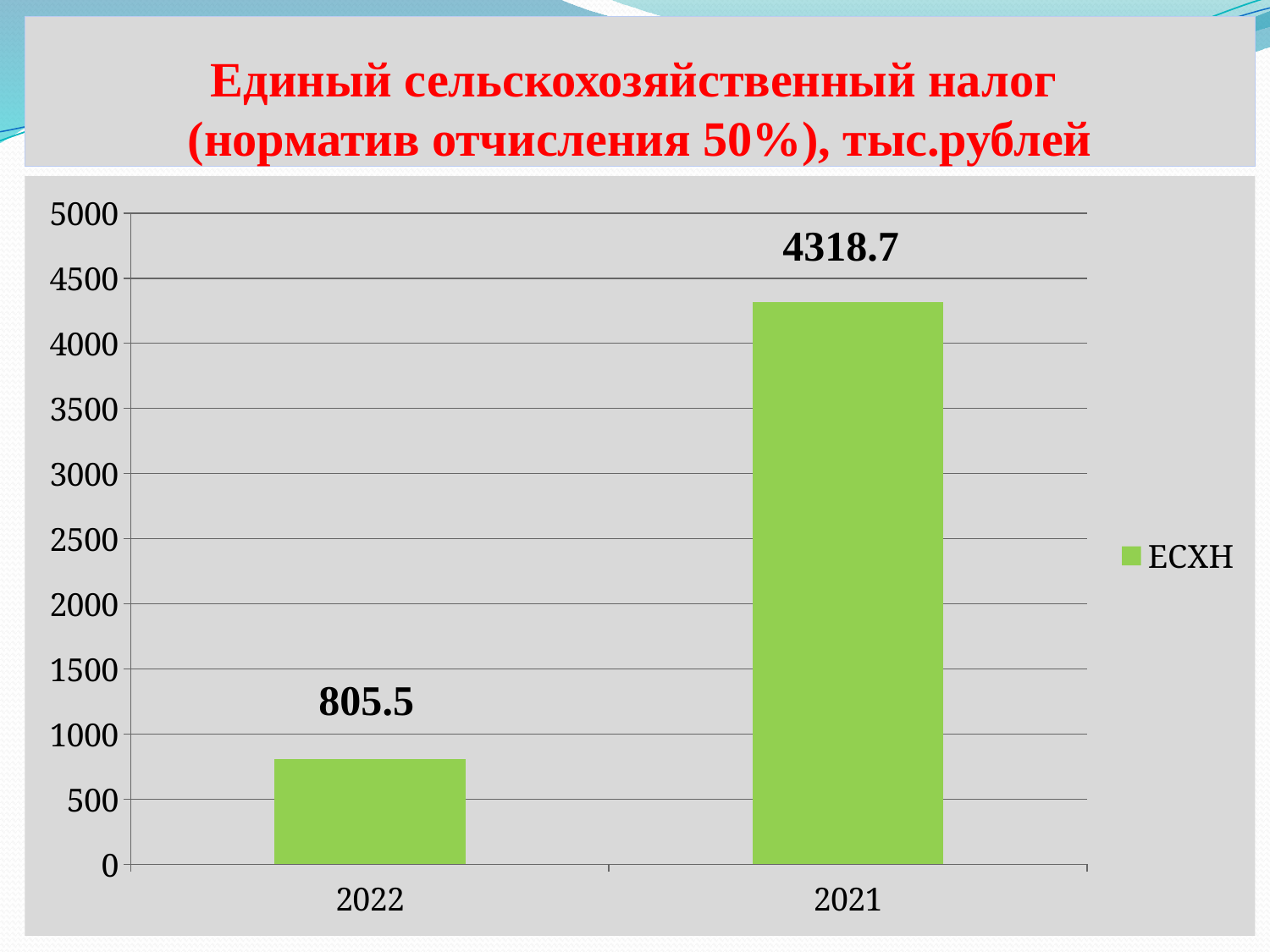
Which year has the highest value? 2021 Is the value for 2022 greater or less than 1000? less How many categories are shown on the x axis? 2 Is the value for 2021 greater or less than 4000? greater How many series does the legend list? 1 Which is larger, the value for 2022 or the value for 2021? 2021 What kind of chart is shown? bar chart What is the difference between the values for 2021 and 2022? 3513.2 Which year has the lowest value? 2022 What is the value for 2022? 805.5 What is the value for 2021? 4318.7 What is the name of the series in the legend? ЕСХН